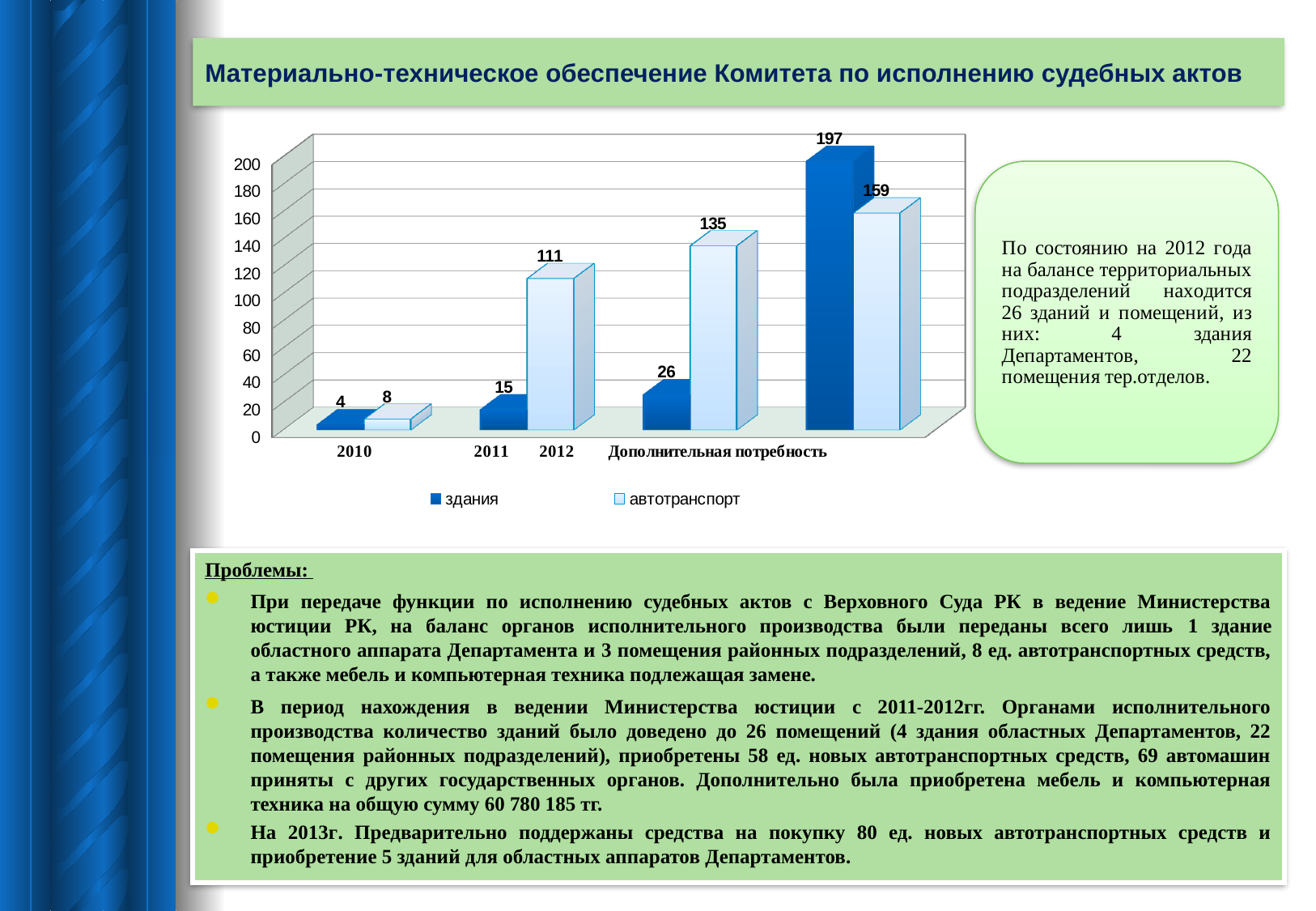
Do the values for автотранспорт rise or fall from 2010 to 2012? rise What kind of chart is shown on the slide? bar chart What is the difference between the автотранспорт values for 2012 and 2011? 24 Which category has the highest value for здания? Дополнительная потребность What is the value for здания in 2010? 4 Which category has the lowest value for автотранспорт? 2010 How many categories are shown on the x axis? 4 What is the value for автотранспорт in 2011? 111 How many series does the legend list? 2 What is the value for здания in 2012? 26 What is the value for автотранспорт under Дополнительная потребность? 159 Which is larger under Дополнительная потребность: здания or автотранспорт? здания